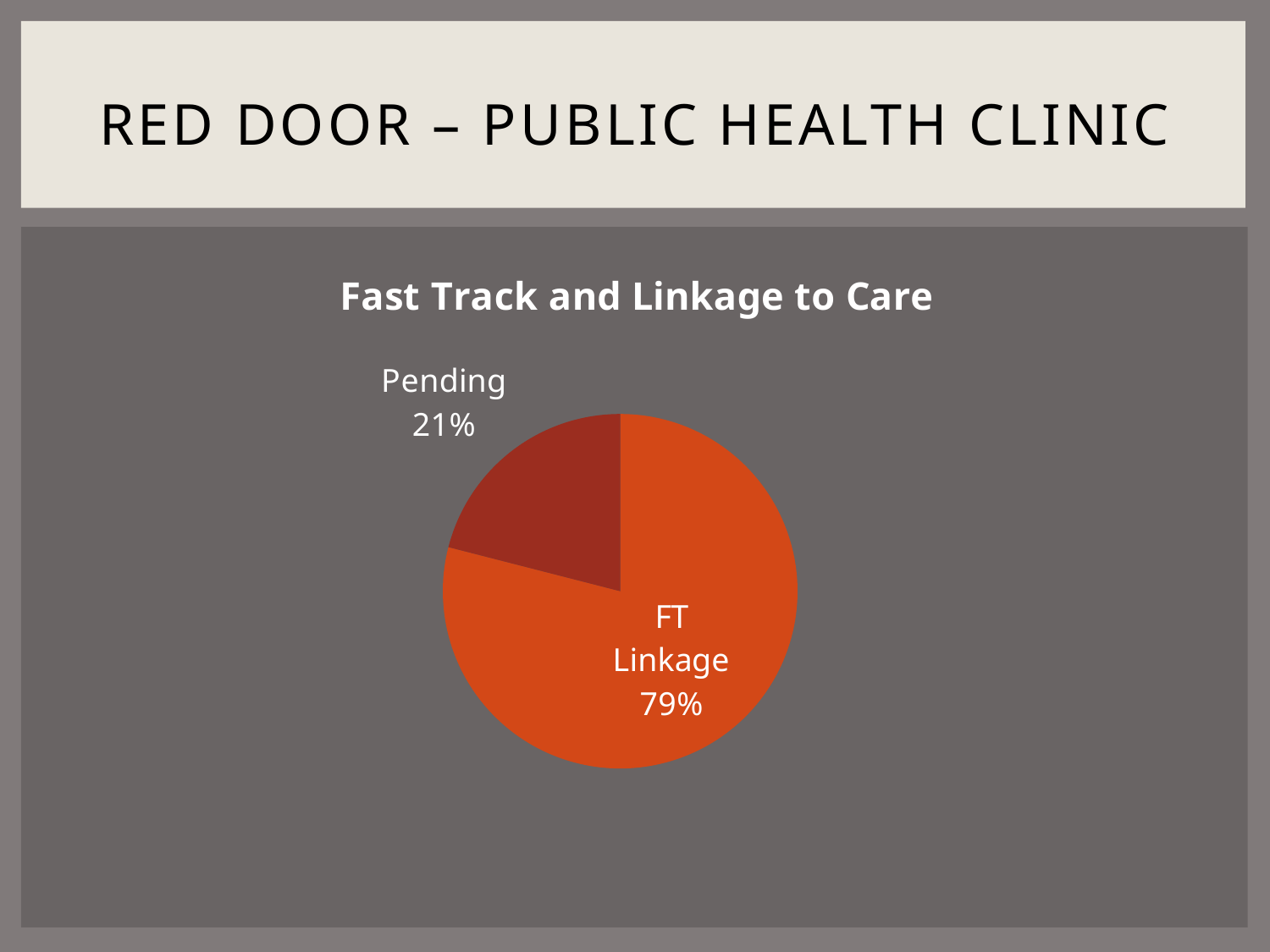
Is the share for Pending greater or less than 50%? less Which slice is the largest? FT Linkage What is the combined share of FT Linkage and Pending? 100% Which slice is the smallest? Pending What kind of chart is shown on the slide? Pie chart What share of the pie is Pending? 21% How many slices does the pie chart have? 2 What share of the pie is FT Linkage? 79% What is the difference in percentage points between FT Linkage and Pending? 58 What is the title of the chart? Fast Track and Linkage to Care Which is larger, the Pending slice or the FT Linkage slice? FT Linkage